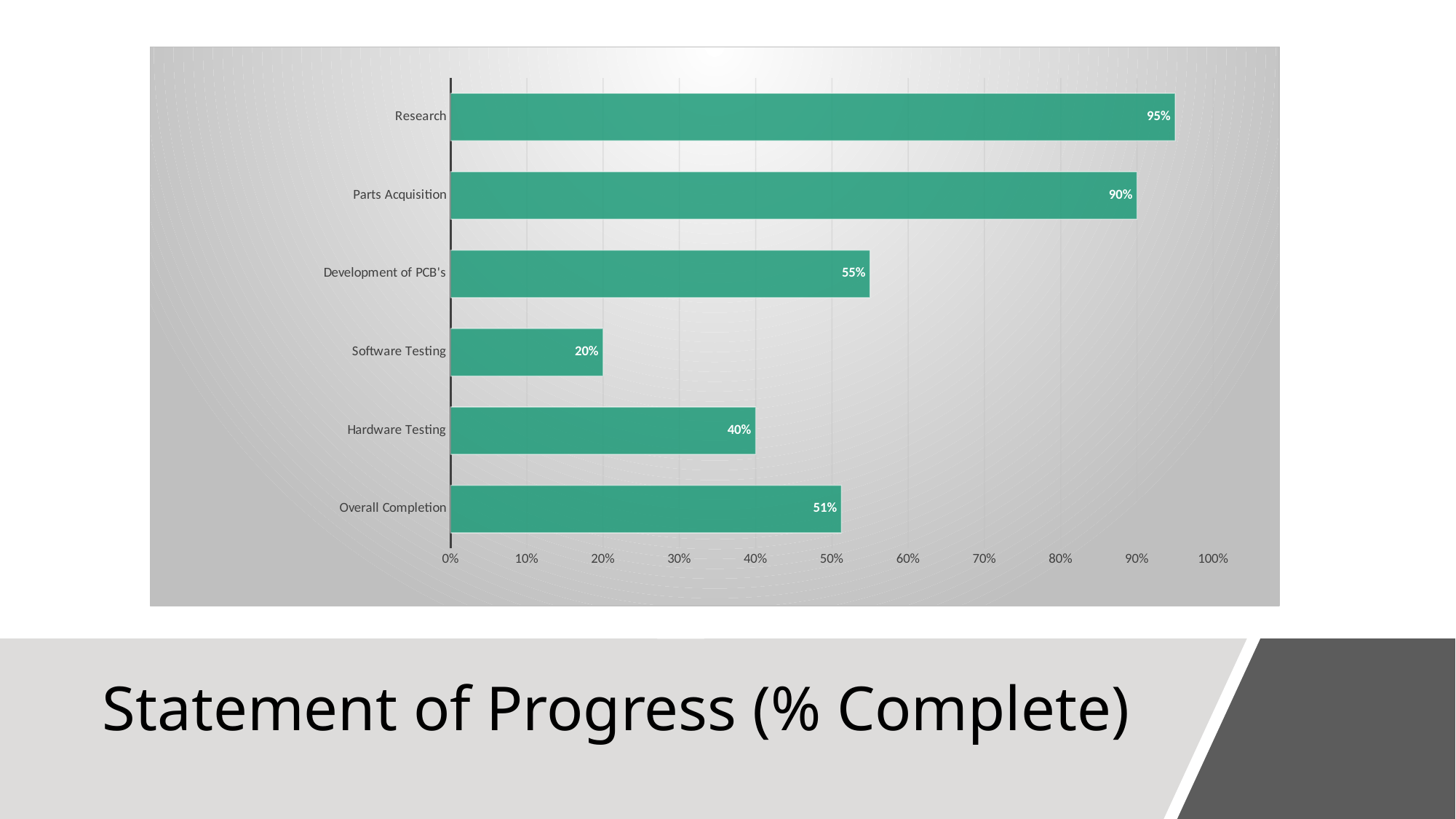
What is the value for Software Testing? 20% Which category has the highest value? Research What is the difference between the values for Development of PCB's and Hardware Testing? 15% What kind of chart is shown on the slide? Bar chart What is the value for Overall Completion? 51% Is the value for Development of PCB's greater or less than 50%? greater What is the value for Research? 95% What is the difference between the values for Research and Parts Acquisition? 5% Which is larger, the value for Hardware Testing or the value for Software Testing? Hardware Testing What is the title of the slide? Statement of Progress (% Complete) How many categories are shown in the chart? 6 Which category has the lowest value? Software Testing